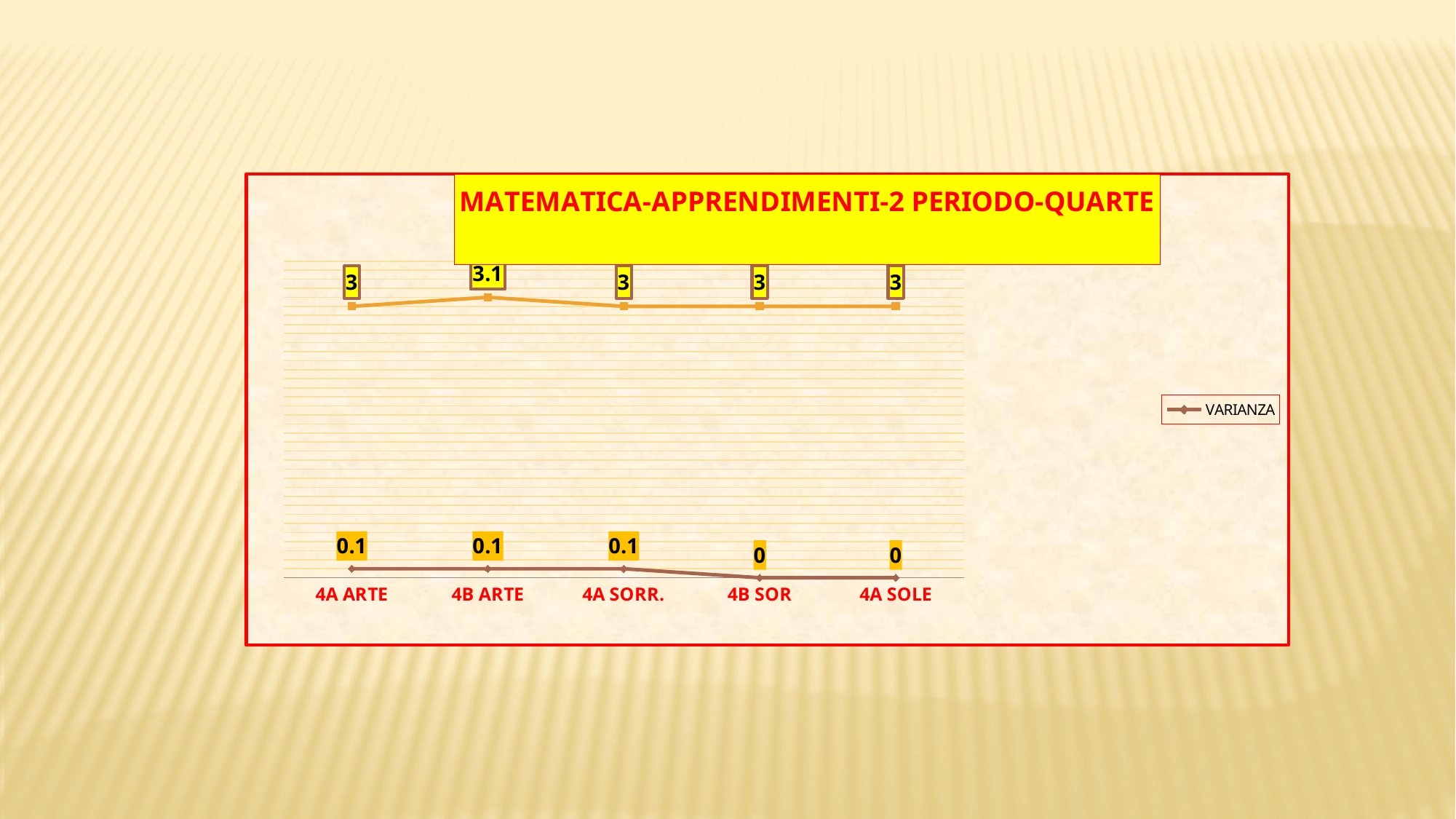
Which category has the highest value on the upper orange line? 4B ARTE What kind of chart is shown on the slide? line chart What is the value of the upper orange line for 4A SOLE? 3 What is the VARIANZA value for 4A ARTE? 0.1 What is the value of the upper orange line for 4B ARTE? 3.1 Which series name is readable in the chart legend? VARIANZA Does the VARIANZA line rise or fall from 4A SORR. to 4B SOR? fall What is the VARIANZA value for 4B SOR? 0 What is the difference between the upper orange line values for 4B ARTE and 4A SORR.? 0.1 What is the title of the chart? MATEMATICA-APPRENDIMENTI-2 PERIODO-QUARTE How many categories are shown on the x axis of the chart? 5 Which is larger, the VARIANZA value for 4A SORR. or for 4A SOLE? 4A SORR.